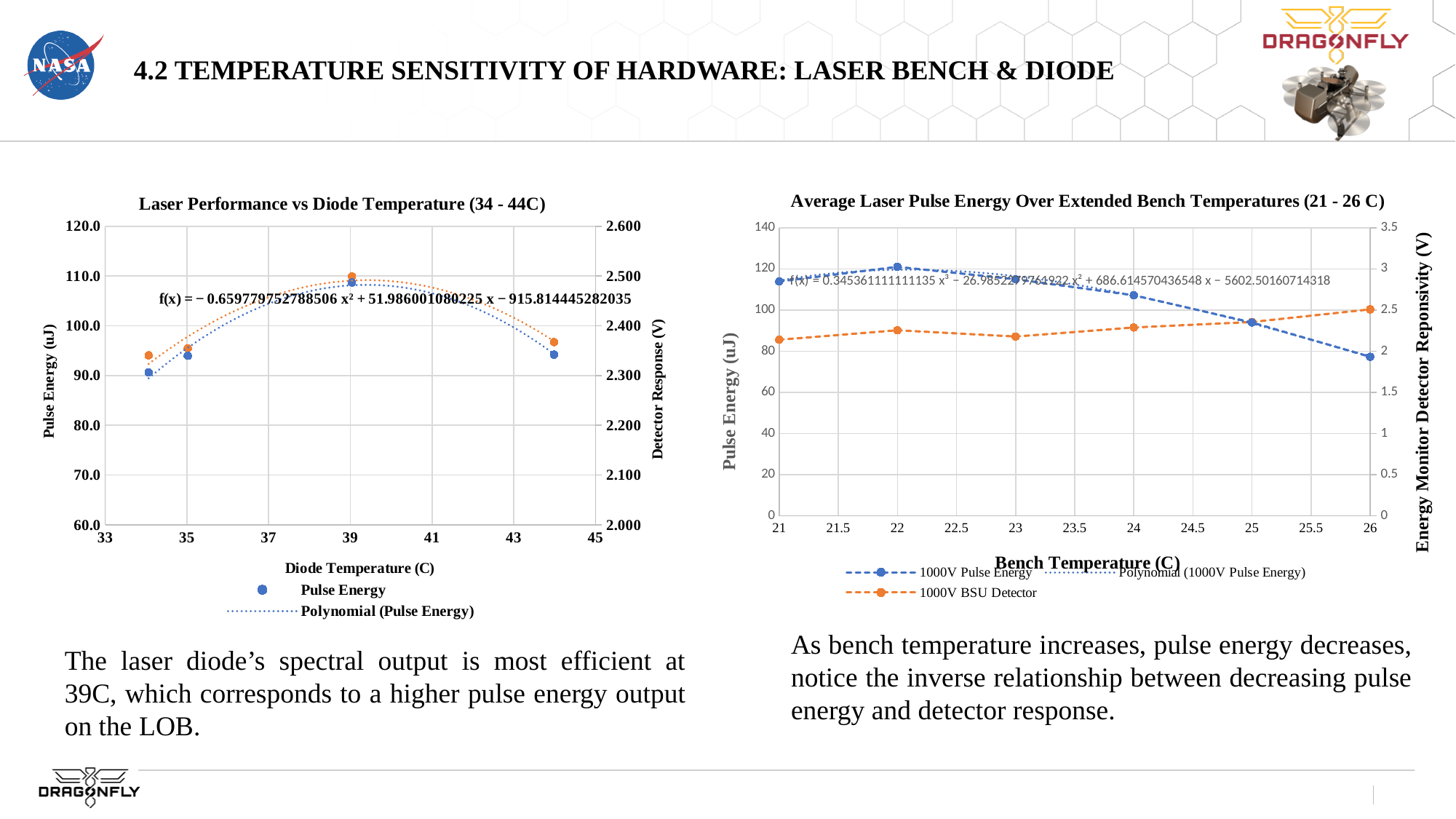
In the left-hand chart, at which diode temperature is the Pulse Energy highest? 39 How many entries does the legend of the left-hand chart list? 2 In the left-hand chart, how many diode temperature points are plotted for Pulse Energy? 4 In the left-hand chart, is the Pulse Energy at 39 C greater or less than 100.0? greater In the right-hand chart, at which bench temperature is the 1000V Pulse Energy highest? 22 In the chart on the right, what is the x-axis title? Bench Temperature (C) What is the title of the chart on the left of the slide? Laser Performance vs Diode Temperature (34 - 44C) How many entries does the legend of the right-hand chart list? 3 In the right-hand chart, how many bench temperature points are plotted for the 1000V Pulse Energy series? 6 In the right-hand chart, does the 1000V Pulse Energy rise or fall as bench temperature goes from 22 to 26? fall In the right-hand chart, is the 1000V Pulse Energy at 26 C greater or less than 100? less In the right-hand chart, at which bench temperature is the 1000V Pulse Energy lowest? 26